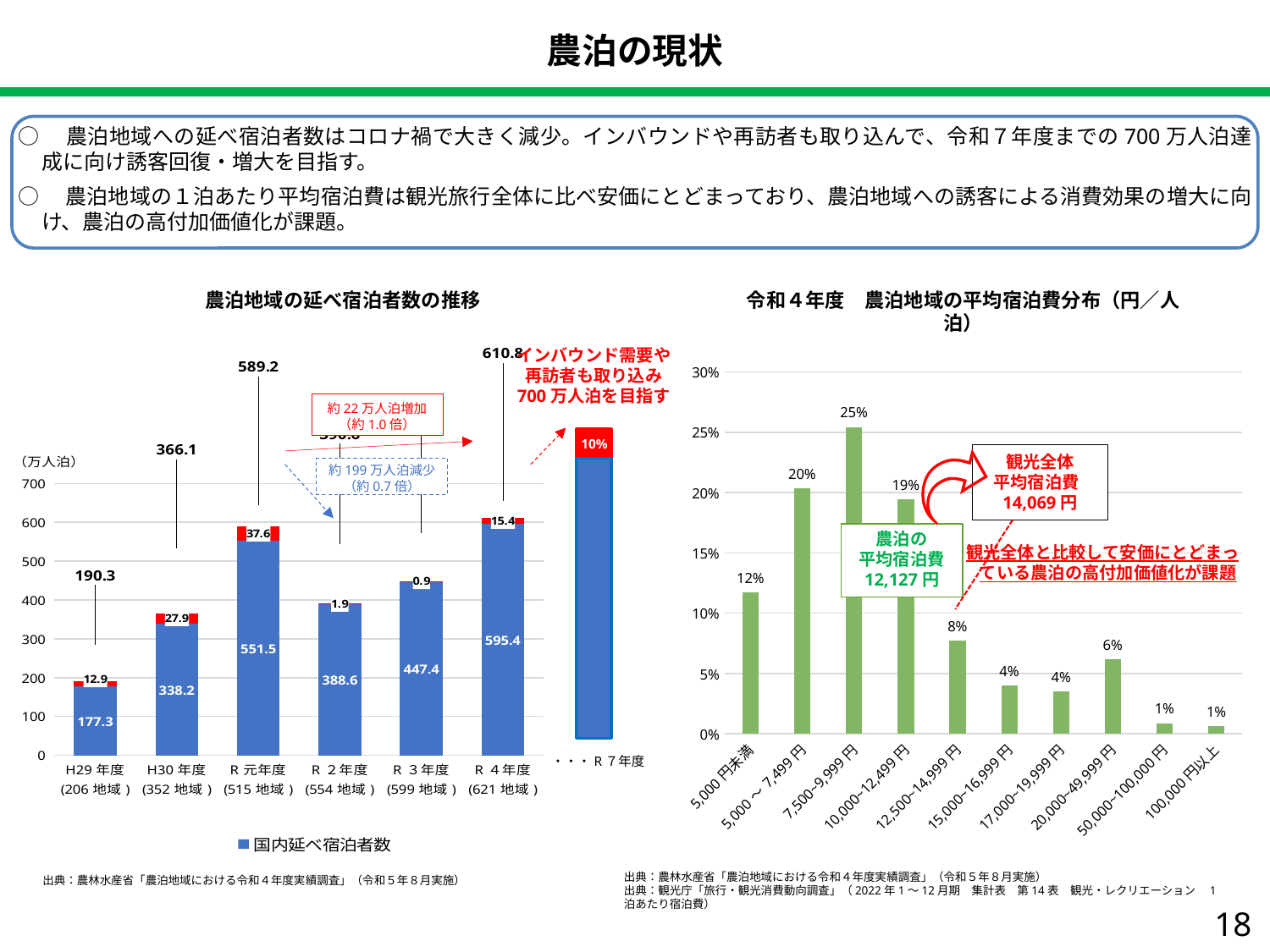
In the left chart 農泊地域の延べ宿泊者数の推移, which is larger, the blue segment for R 2年度 or the blue segment for R 3年度? R 3年度 In the left chart 農泊地域の延べ宿泊者数の推移, which fiscal year has the lowest total value? H29 年度 In the left chart 農泊地域の延べ宿泊者数の推移, how many series does the legend list? 1 What kind of chart is the right chart 令和4年度 農泊地域の平均宿泊費分布? Bar chart In the right chart 令和4年度 農泊地域の平均宿泊費分布, which price range has the highest percentage? 7,500～9,999 円 In the left chart 農泊地域の延べ宿泊者数の推移, what is the difference between the total for R 4年度 (610.8) and the total for R 元年度 (589.2)? 21.6 In the right chart 令和4年度 農泊地域の平均宿泊費分布, what percentage is shown for 7,500～9,999 円? 25% In the left chart 農泊地域の延べ宿泊者数の推移, what is the total value labelled for R 4年度? 610.8 In the right chart 令和4年度 農泊地域の平均宿泊費分布, how many price-range categories are plotted? 10 In the left chart 農泊地域の延べ宿泊者数の推移, what is the total value labelled for R 元年度? 589.2 In the right chart 令和4年度 農泊地域の平均宿泊費分布, what is the difference between the percentage for 5,000～7,499 円 and the percentage for 12,500～14,999 円? 12% In the left chart 農泊地域の延べ宿泊者数の推移, what is the value of the blue 国内延べ宿泊者数 segment for H29 年度? 177.3